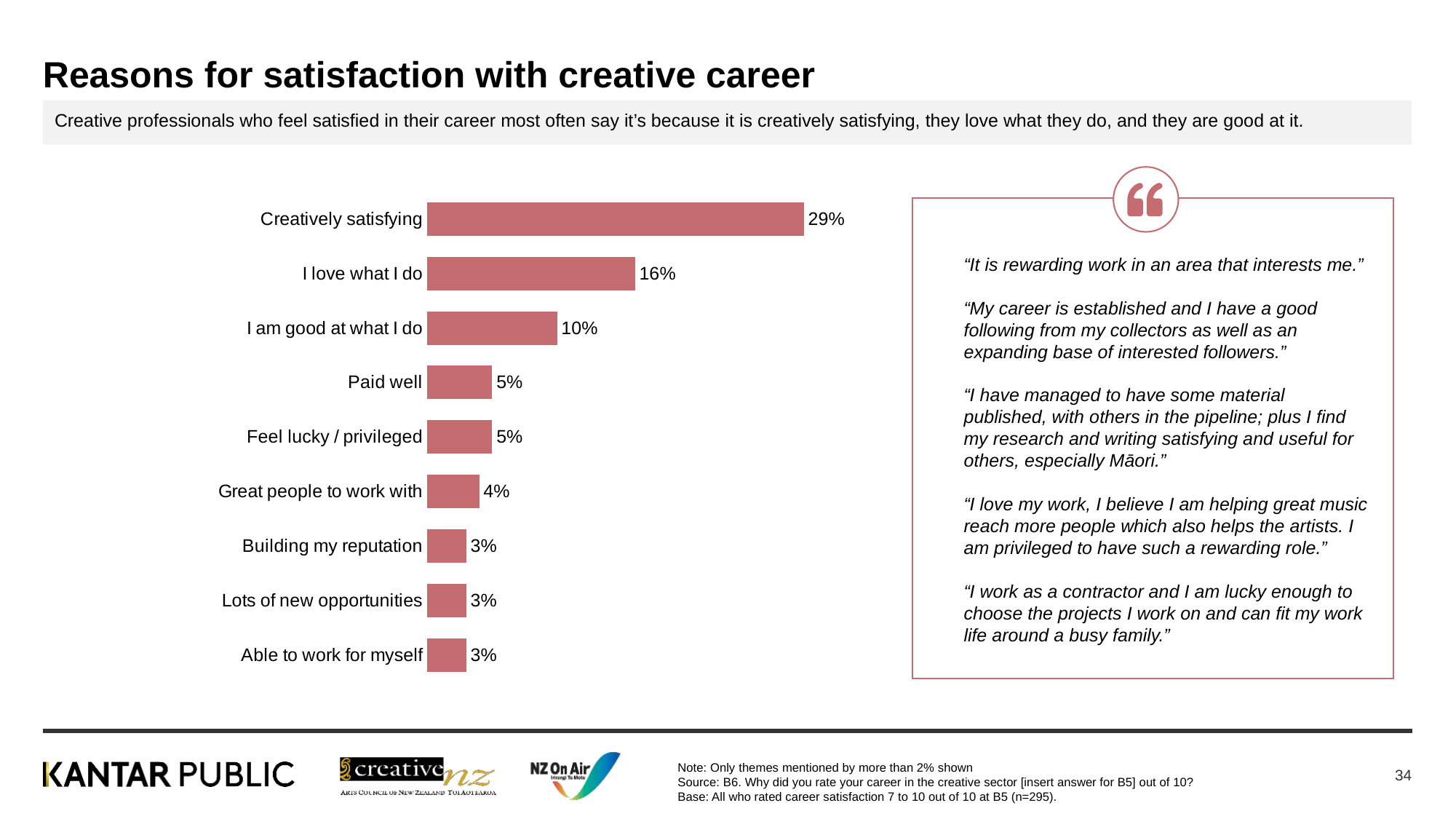
How many reasons have a value of 3%? 3 What is the title of the slide? Reasons for satisfaction with creative career How many reasons are shown in the chart? 9 What is the difference between "I love what I do" and "I am good at what I do"? 6 percentage points What is the value for "Great people to work with"? 4% Which reason has the highest percentage? Creatively satisfying What is the value for "I love what I do"? 16% What percentage is shown for "Paid well"? 5% What kind of chart is shown on the slide? Bar chart Which is larger, "I am good at what I do" or "Paid well"? I am good at what I do What is the difference between "Creatively satisfying" and "I love what I do"? 13 percentage points What percentage of respondents said their career is creatively satisfying? 29%